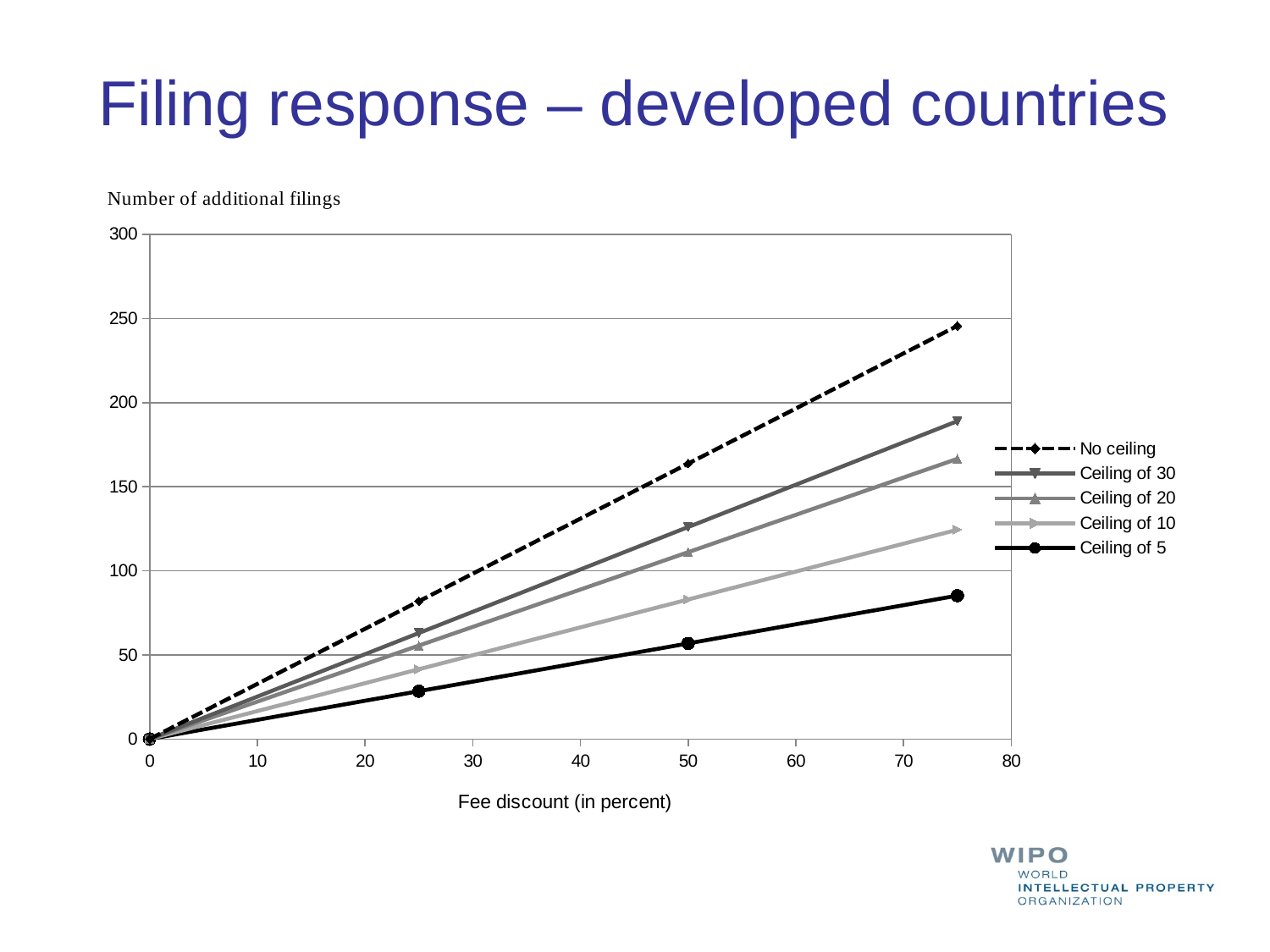
Is the value for Ceiling of 30 at a fee discount of 50 percent greater or less than 100? greater Is the value for No ceiling at a fee discount of 75 percent greater or less than 200? greater Which series has the highest number of additional filings at a fee discount of 75 percent? No ceiling How many series does the legend list? 5 Do the number of additional filings rise or fall as the fee discount increases? rise What is the title of the x axis? Fee discount (in percent) At a fee discount of 75 percent, which is larger: the value for Ceiling of 20 or the value for Ceiling of 10? Ceiling of 20 Which series has the lowest number of additional filings at a fee discount of 75 percent? Ceiling of 5 How many data points are plotted for each series? 4 What kind of chart is shown on the slide? line chart Is the value for Ceiling of 10 at a fee discount of 50 percent greater or less than 100? less